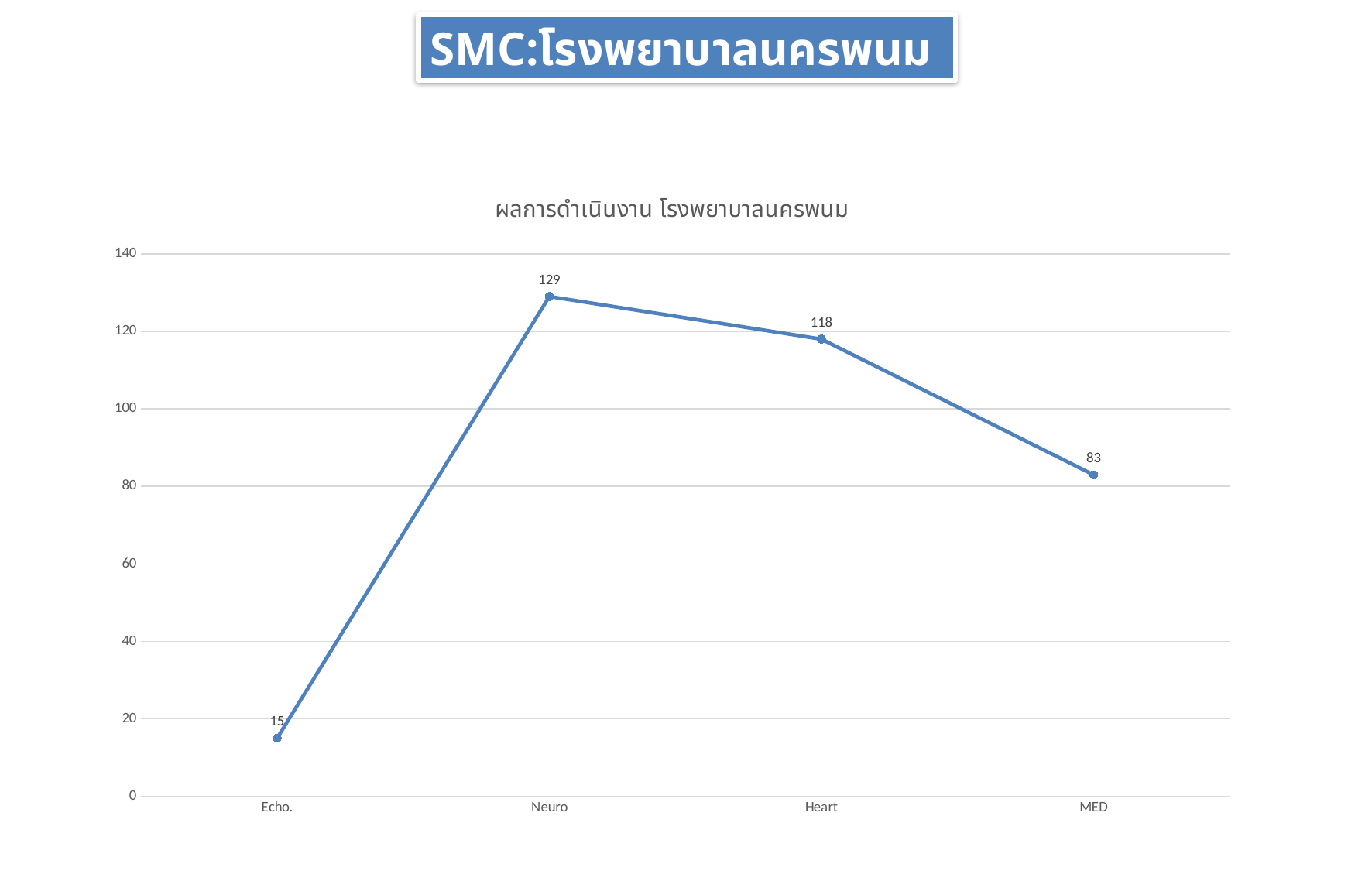
What is the value for Heart? 118 Which category has the highest value? Neuro What is the value for Echo.? 15 How many categories are shown on the x axis? 4 What kind of chart is this? Line chart Which category has the lowest value? Echo. What is the title of the chart? ผลการดำเนินงาน โรงพยาบาลนครพนม Which is larger, the value for Heart or the value for MED? Heart What is the difference between the values for Heart and MED? 35 What is the value for Neuro? 129 What is the difference between the values for Neuro and Heart? 11 What is the value for MED? 83